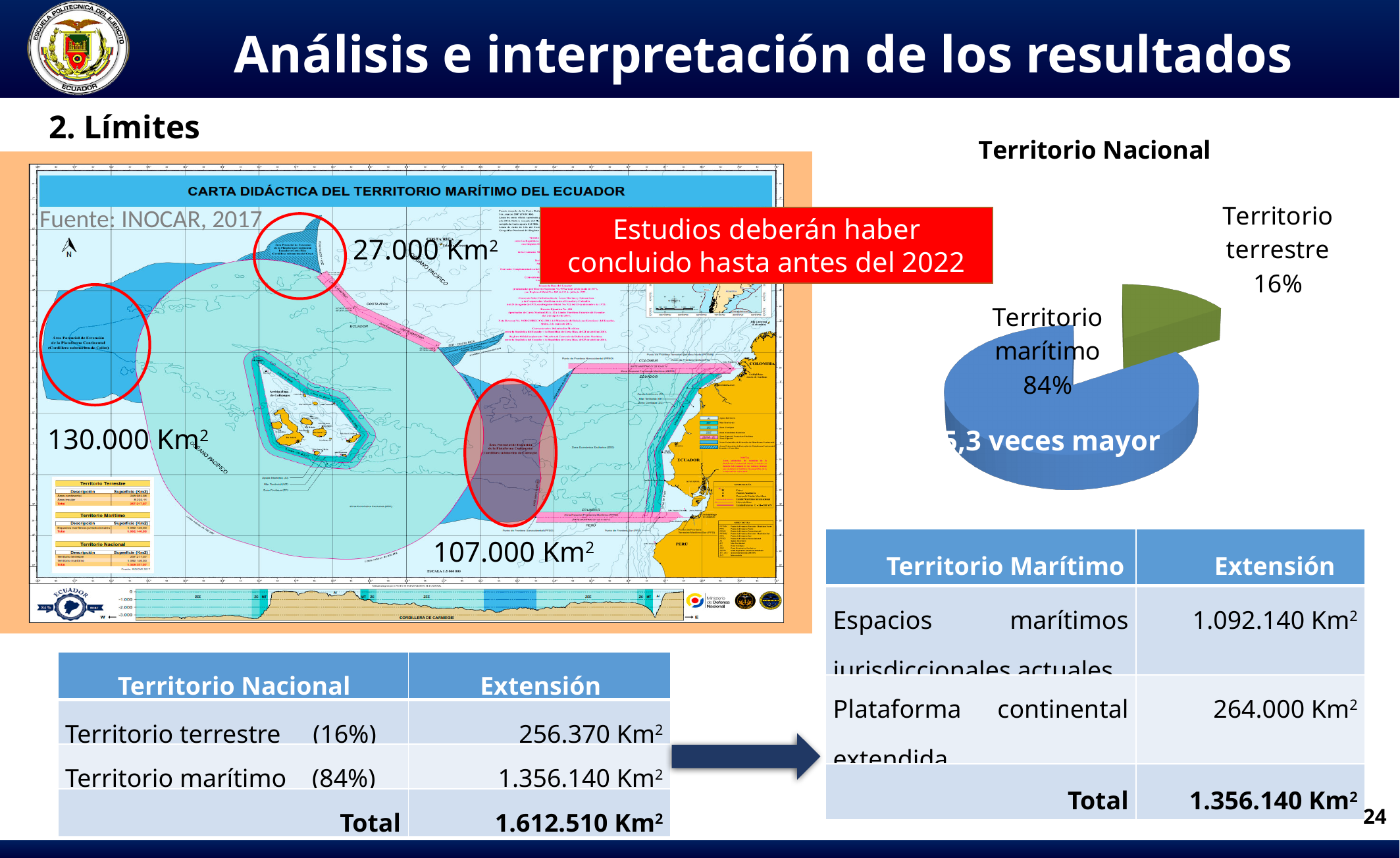
Which slice of the "Territorio Nacional" pie chart is the largest? Territorio marítimo In the "Territorio Nacional" pie chart, what share is labelled for Territorio terrestre? 16% What do the two slices of the "Territorio Nacional" pie chart add up to? 100% Which slice of the "Territorio Nacional" pie chart is the smallest? Territorio terrestre How many slices does the "Territorio Nacional" pie chart have? 2 In the "Territorio Nacional" pie chart, which is larger: Territorio terrestre or Territorio marítimo? Territorio marítimo What is the title of the pie chart on the slide? Territorio Nacional In the "Territorio Nacional" pie chart, by how many percentage points does Territorio marítimo exceed Territorio terrestre? 68 percentage points In the "Territorio Nacional" pie chart, what share is labelled for Territorio marítimo? 84% In the "Territorio Nacional" pie chart, what colour is the Territorio terrestre slice? Green What kind of chart is the "Territorio Nacional" chart on the slide? Pie chart